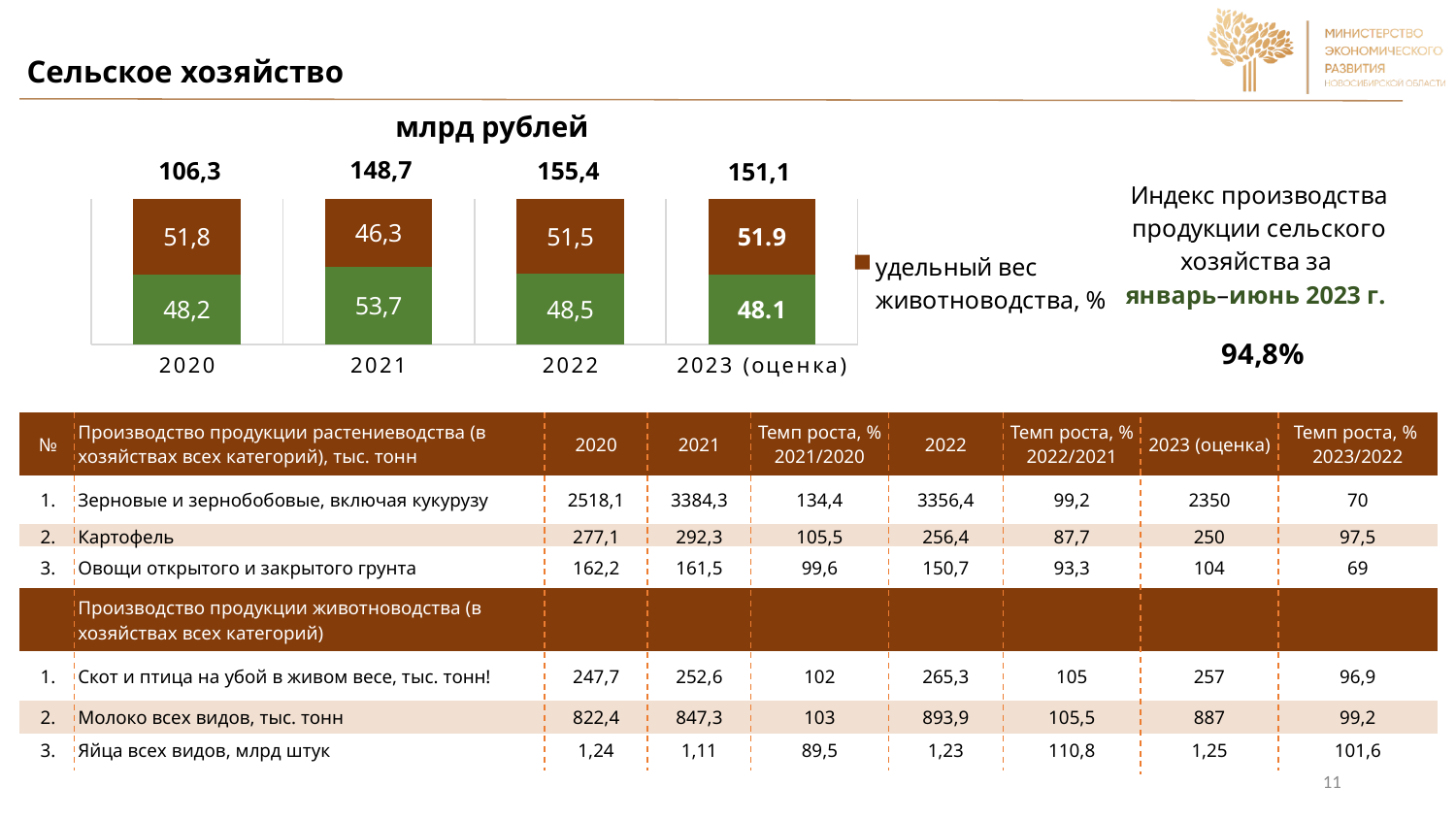
What kind of chart is shown under the title "млрд рублей"? stacked bar chart In the "млрд рублей" chart, what is the difference between the total values printed for 2022 and 2020? 49,1 How many categories (years) are shown on the x axis of the "млрд рублей" chart? 4 What legend entry is shown to the right of the "млрд рублей" chart? удельный вес животноводства, % In the "млрд рублей" chart, does the total value printed above the bars rise or fall from 2020 to 2022? rise In the "млрд рублей" chart, what is the value of the green (bottom) segment for 2022? 48,5 In the "млрд рублей" chart, what is the value of the brown segment (удельный вес животноводства, %) for 2021? 46,3 In the "млрд рублей" chart, what total value is printed above the bar for 2021? 148,7 In the "млрд рублей" chart, is the brown segment (удельный вес животноводства, %) larger in 2020 or in 2021? 2020 In the "млрд рублей" chart, which year has the lowest total value printed above its bar? 2020 In the "млрд рублей" chart, what total value is printed above the bar for 2023 (оценка)? 151,1 In the "млрд рублей" chart, which year has the highest total value printed above its bar? 2022